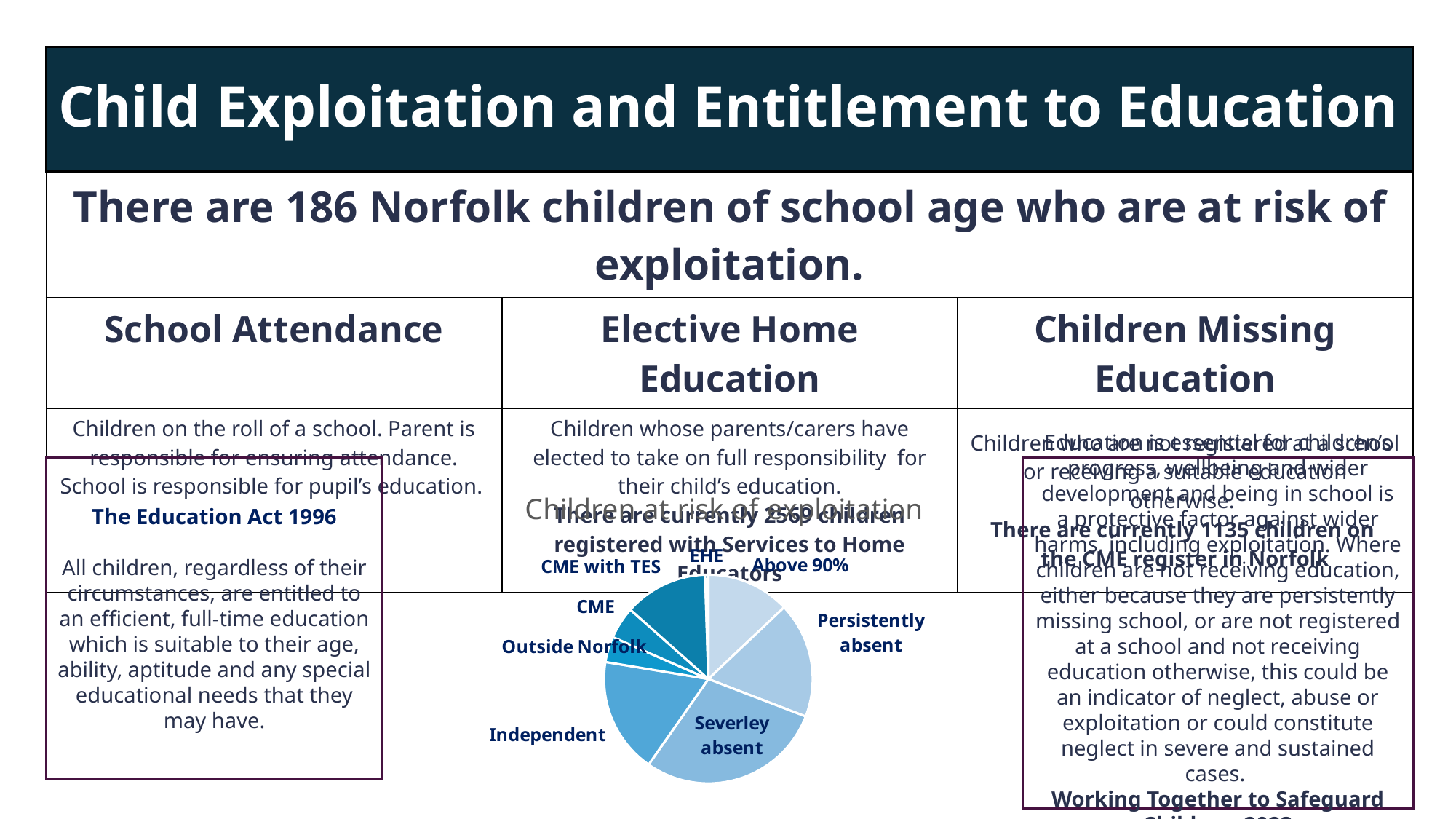
Which slice is larger in the pie chart, Above 90% or EHE? Above 90% Which slice is larger in the pie chart, Independent or CME? Independent Which slice is larger in the pie chart, Severley absent or Outside Norfolk? Severley absent Which slice of the pie chart is the smallest? EHE Is the slice labelled 'Outside Norfolk' one of the larger or smaller slices of the pie chart? smaller What is the title of the pie chart? Children at risk of exploitation How many slices does the pie chart have? 8 What kind of chart is shown on the slide? pie chart